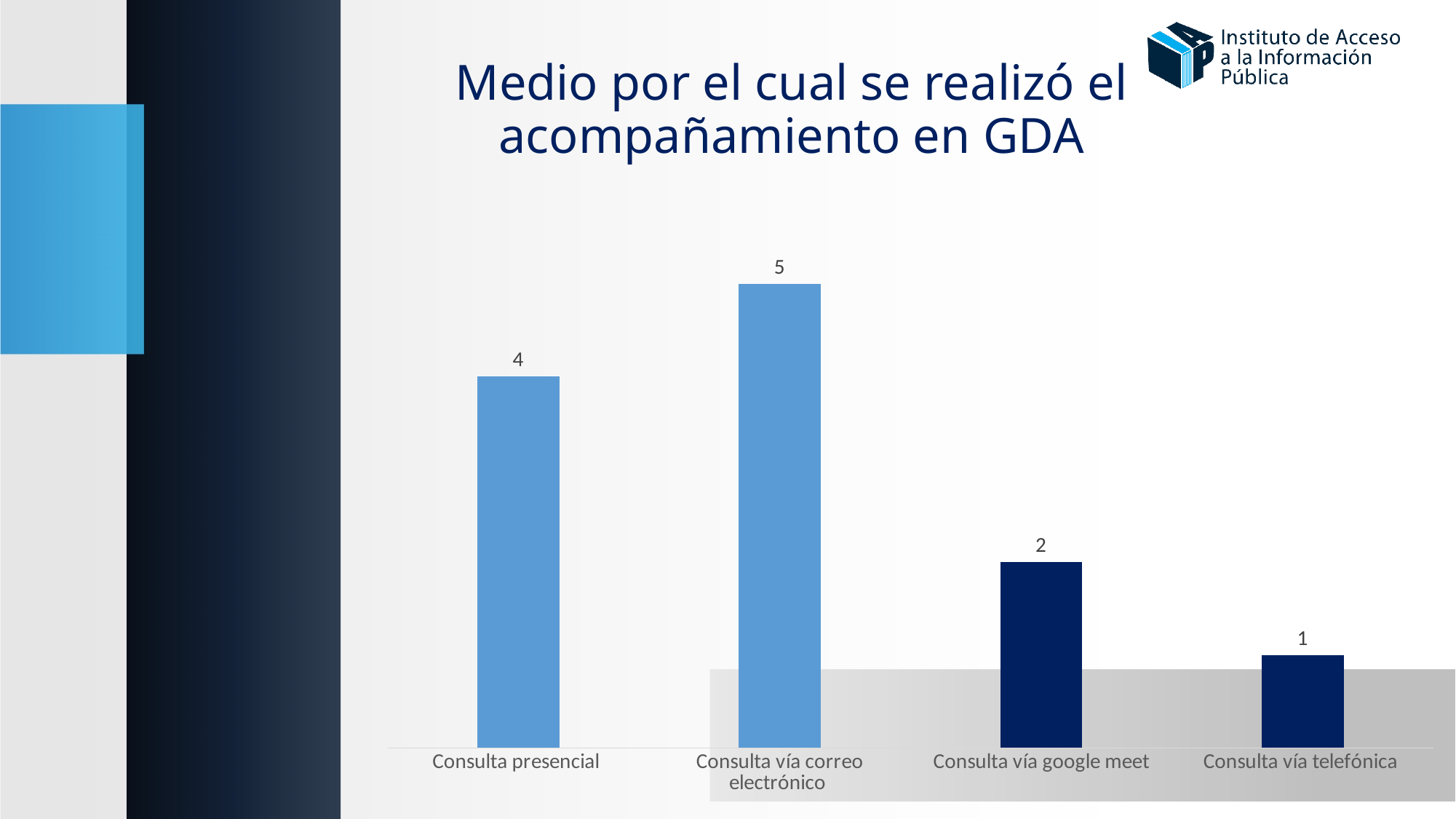
What kind of chart is shown on the slide? Bar chart What is the value for Consulta vía google meet? 2 Which category has the highest value? Consulta vía correo electrónico What is the value for Consulta vía telefónica? 1 What is the title of the slide containing the chart? Medio por el cual se realizó el acompañamiento en GDA Which is larger, the value for Consulta vía google meet or the value for Consulta vía telefónica? Consulta vía google meet What is the value for Consulta vía correo electrónico? 5 What is the difference between the values for Consulta vía correo electrónico and Consulta presencial? 1 Which category has the lowest value? Consulta vía telefónica How many categories are shown in the chart? 4 What is the value for Consulta presencial? 4 What is the difference between the values for Consulta presencial and Consulta vía telefónica? 3